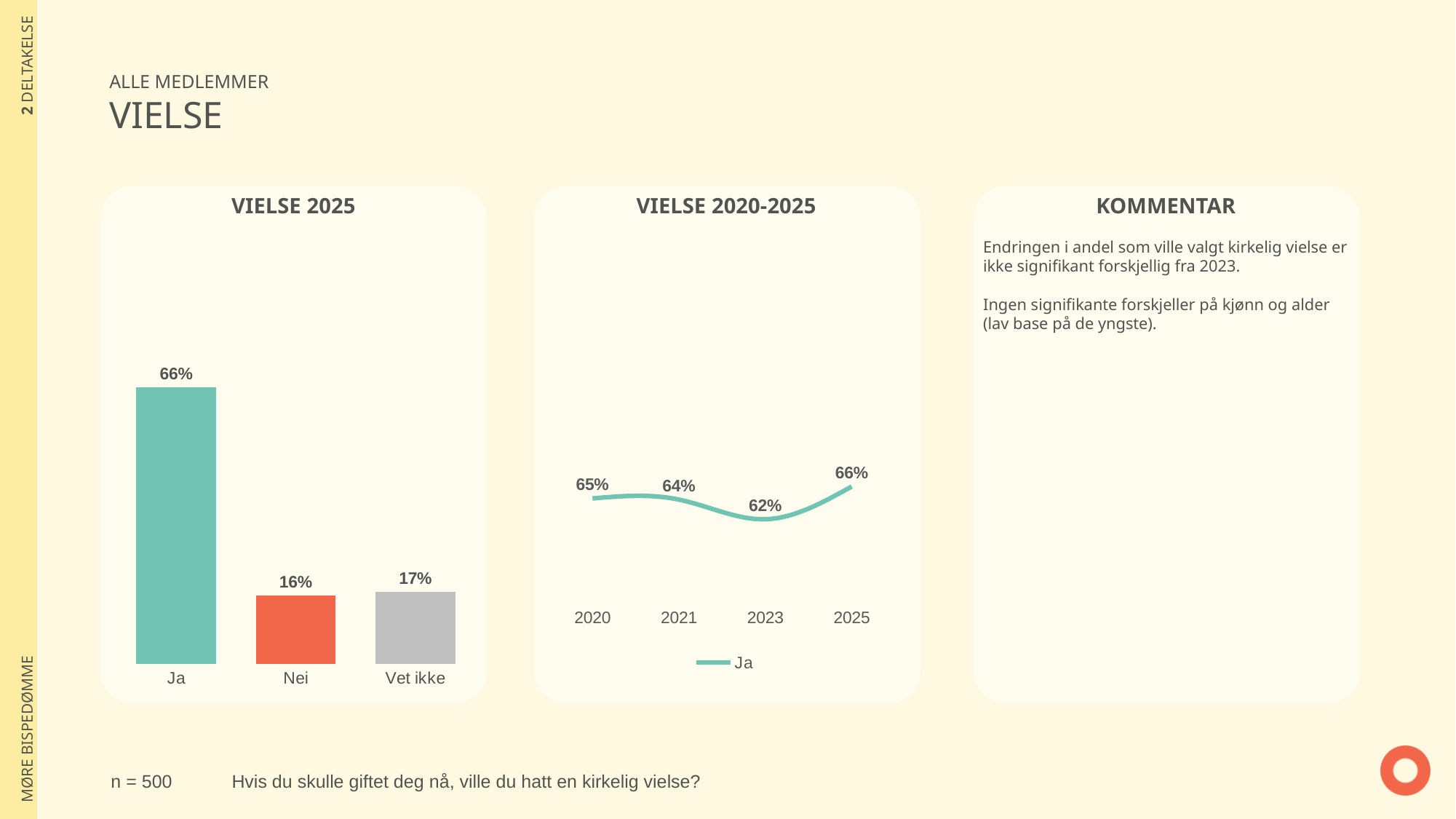
In the VIELSE 2025 chart, which category has the highest value? Ja In the VIELSE 2025 chart, which category has the lowest value? Nei In the VIELSE 2025 chart, what is the value for Ja? 66% In the VIELSE 2020-2025 chart, what is the difference between 2025 and 2023? 4 percentage points What kind of chart is the VIELSE 2025 chart? Bar chart In the VIELSE 2025 chart, what is the value for Nei? 16% What kind of chart is the VIELSE 2020-2025 chart? Line chart In the VIELSE 2025 chart, how many categories are shown? 3 In the VIELSE 2020-2025 chart, how many series does the legend list? 1 In the VIELSE 2020-2025 chart, which year has the lowest value? 2023 In the VIELSE 2020-2025 chart, what is the value for 2023? 62% In the VIELSE 2025 chart, what is the difference between Ja and Vet ikke? 49 percentage points